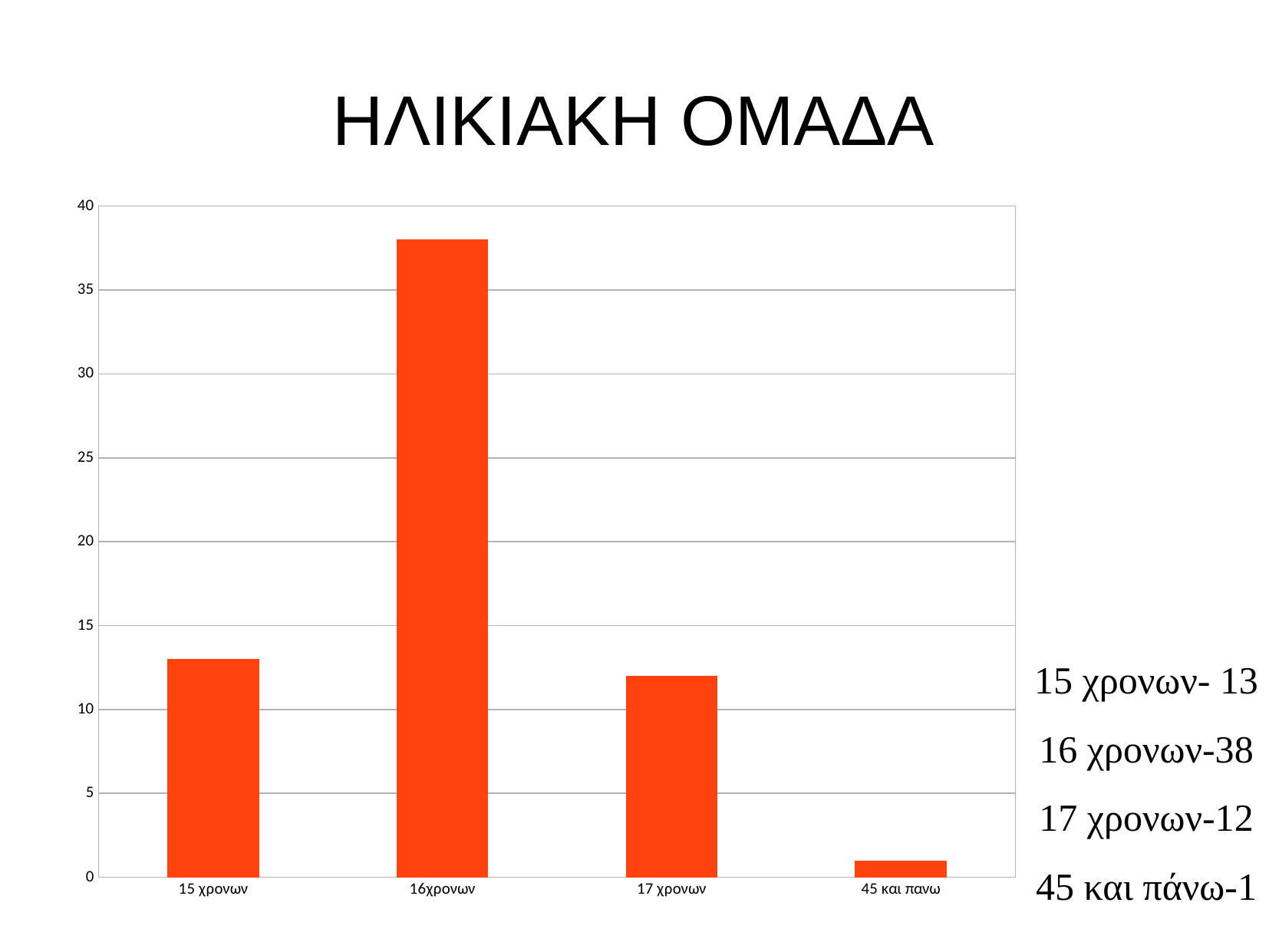
Which age group has the highest value? 16 χρονων Is the value for 16 χρονων greater or less than 35? greater What is the difference between the values for 15 χρονων and 17 χρονων? 1 Which age group has the lowest value? 45 και πανω Which is larger, the value for 15 χρονων or the value for 45 και πανω? 15 χρονων What kind of chart is shown on the slide? bar chart What is the difference between the values for 16 χρονων and 17 χρονων? 26 How many age groups are shown in the chart? 4 What is the title of the chart? ΗΛΙΚΙΑΚΗ ΟΜΑΔΑ What is the value for 45 και πανω? 1 What is the value for 16 χρονων? 38 What is the value for 15 χρονων? 13